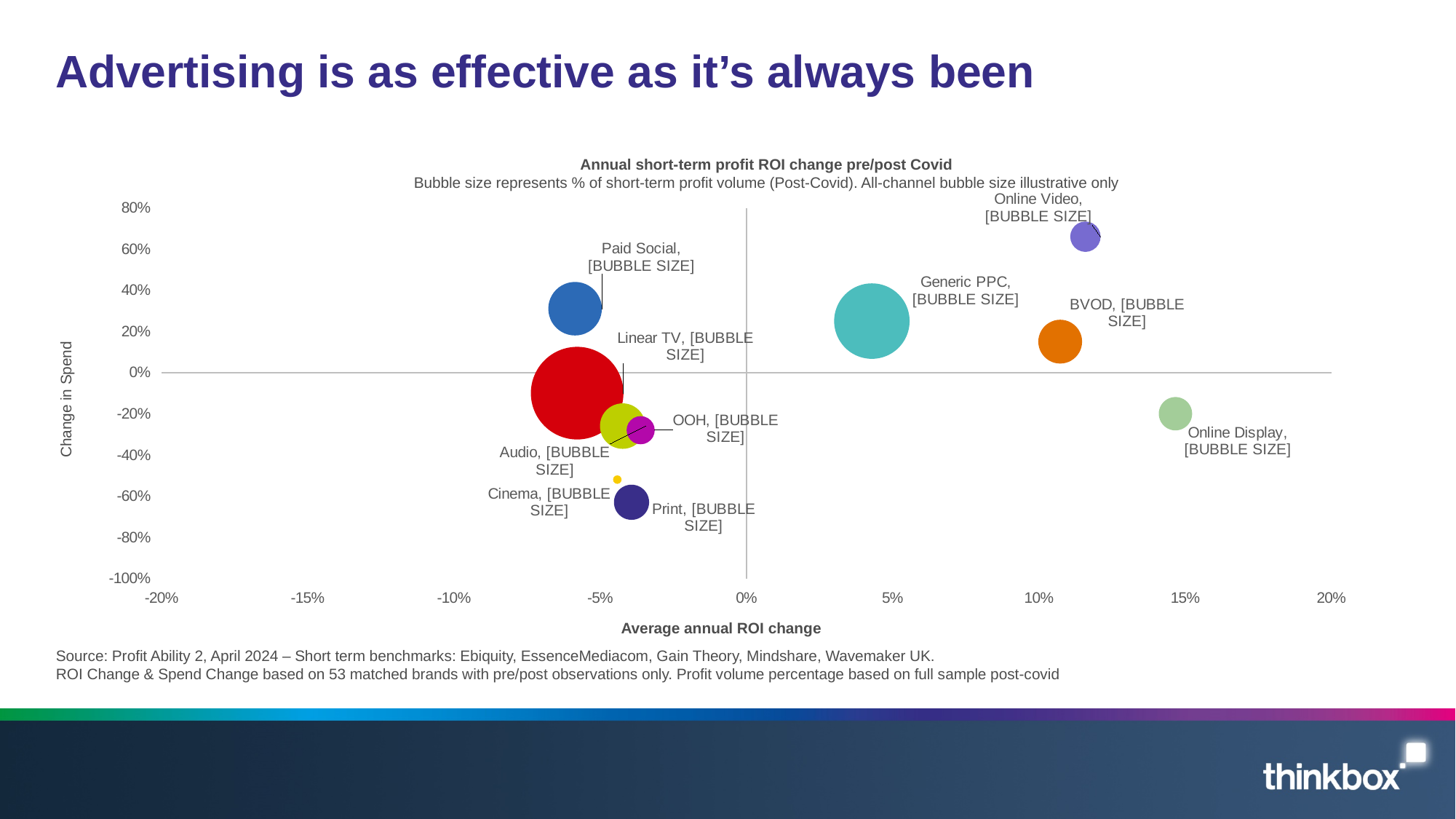
Which channel has the lowest change in spend? Print Is the change in spend for Print greater or less than -40%? less What kind of chart is shown on the slide? Bubble chart Which channel has the highest average annual ROI change? Online Display What is the title of the horizontal axis? Average annual ROI change Is the average annual ROI change for Online Display greater or less than 10%? greater Is the change in spend for Online Video greater or less than 60%? greater Which has the larger average annual ROI change, Generic PPC or Paid Social? Generic PPC Which channel is represented by the largest bubble? Linear TV How many channels (bubbles) are plotted on the chart? 10 Which channel has the highest change in spend? Online Video